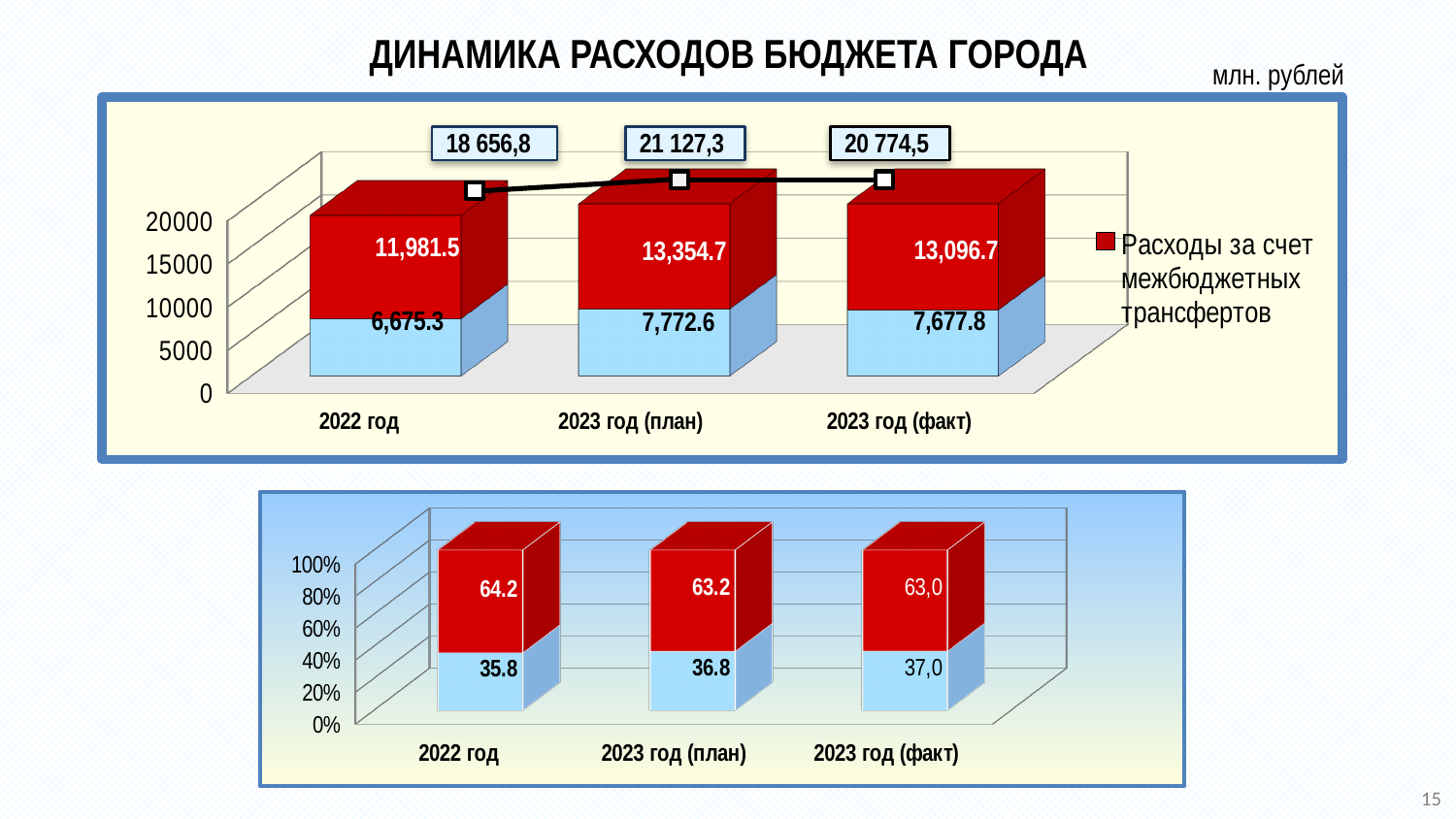
In the top chart, what is the value of Расходы за счет межбюджетных трансфертов for 2022 год? 11,981.5 What kind of chart is the top chart? bar chart How many categories are shown on the x axis of the top chart? 3 In the top chart, which is larger: the lower (light blue) segment for 2023 год (план) or for 2023 год (факт)? 2023 год (план) In the bottom chart, which category has the highest value for the red segment? 2022 год In the bottom chart, what value is shown for the light blue segment for 2022 год? 35.8 In the bottom chart, what value is shown for the red segment for 2023 год (факт)? 63,0 In the top chart, which category has the lowest total shown above the bars? 2022 год In the top chart, which category has the highest total shown above the bars? 2023 год (план) How many series does the legend of the top chart list? 1 In the top chart, what total is shown above the bar for 2023 год (план)? 21 127,3 In the top chart, what is the difference between the Расходы за счет межбюджетных трансфертов values for 2023 год (план) and 2023 год (факт)? 258.0